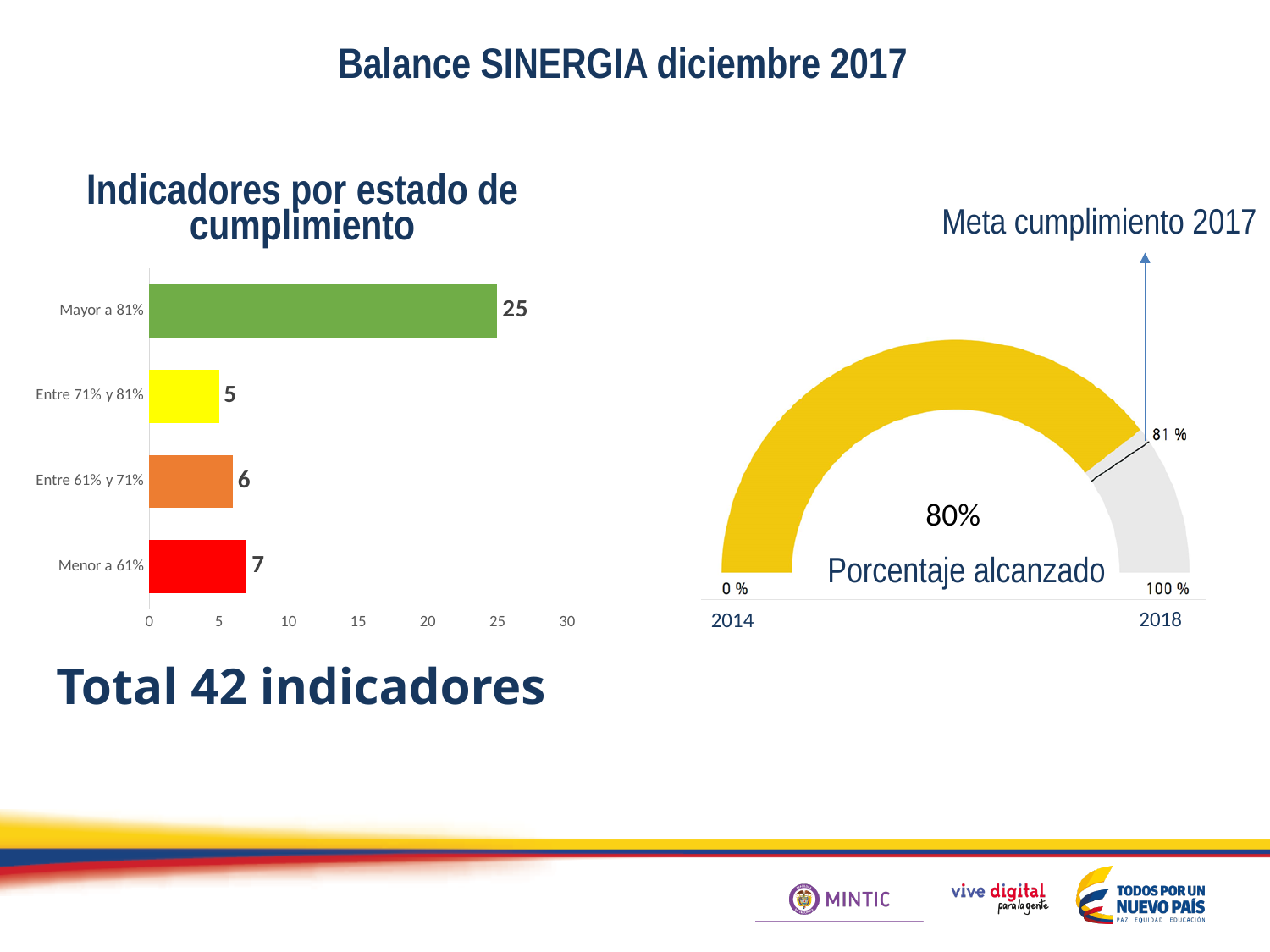
In the 'Indicadores por estado de cumplimiento' chart, which category has the lowest value? Entre 71% y 81% In the 'Indicadores por estado de cumplimiento' chart, what is the difference between the values for 'Mayor a 81%' and 'Menor a 61%'? 18 What kind of chart is 'Indicadores por estado de cumplimiento'? Bar chart In the 'Meta cumplimiento 2017' gauge chart, what is the 'Porcentaje alcanzado'? 80% In the 'Indicadores por estado de cumplimiento' chart, what is the value for 'Mayor a 81%'? 25 In the 'Indicadores por estado de cumplimiento' chart, what is the value for 'Entre 71% y 81%'? 5 In the 'Indicadores por estado de cumplimiento' chart, what is the value for 'Menor a 61%'? 7 In the 'Meta cumplimiento 2017' gauge chart, what target value is marked by the arrow? 81 % In the 'Indicadores por estado de cumplimiento' chart, which category has the highest value? Mayor a 81% In the 'Indicadores por estado de cumplimiento' chart, which is larger: the value for 'Entre 61% y 71%' or 'Entre 71% y 81%'? Entre 61% y 71% What colour is the 'Mayor a 81%' bar in the 'Indicadores por estado de cumplimiento' chart? Green How many categories are shown in the 'Indicadores por estado de cumplimiento' chart? 4